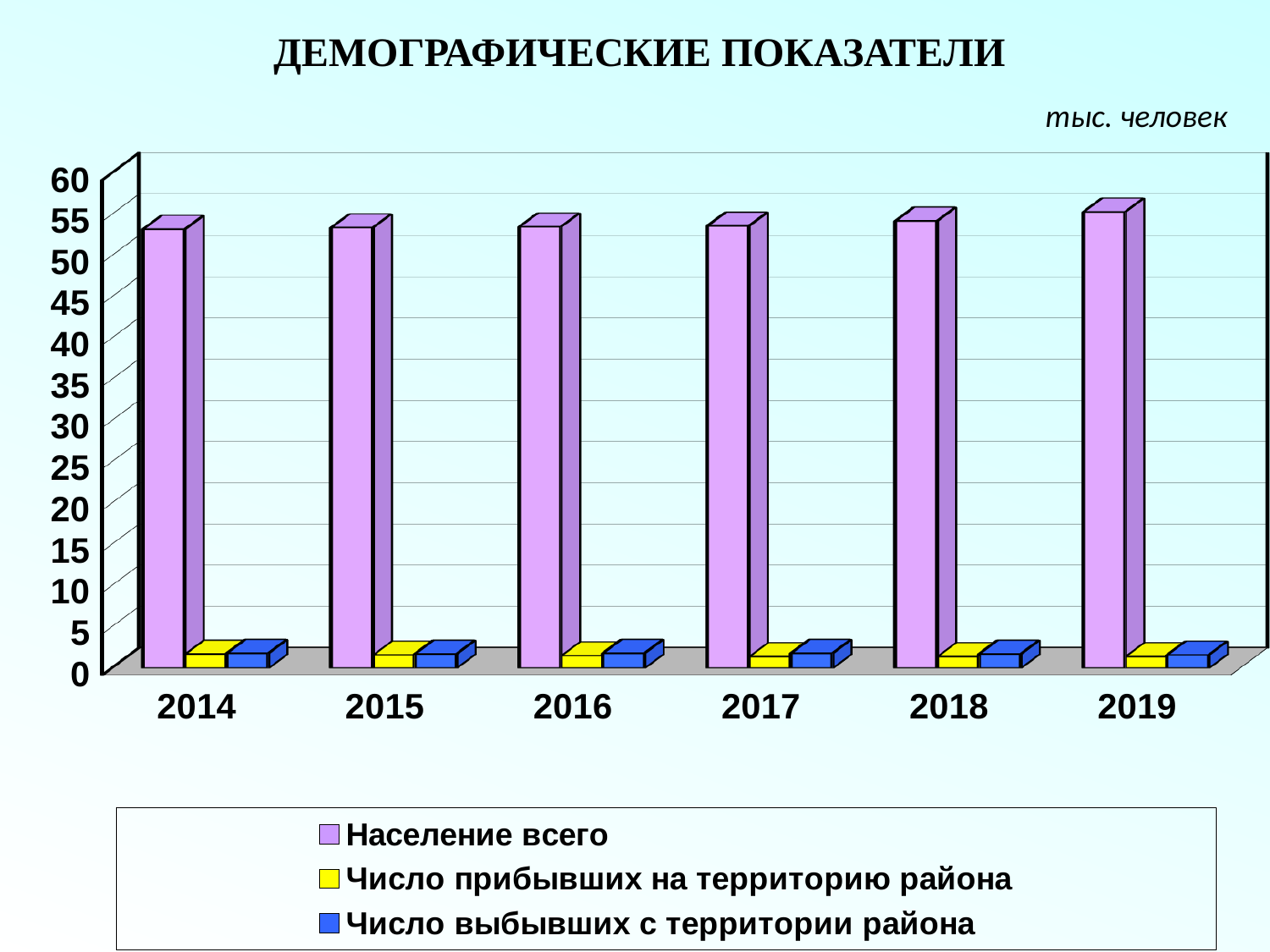
Is the value for Число прибывших на территорию района in 2016 greater or less than 5? less How many series does the legend list? 3 How many years are shown on the x axis of the chart? 6 Which series has the highest values in every year shown? Население всего What kind of chart is shown on the slide? bar chart Is the value for Население всего in 2019 greater or less than 60? less Is the value for Число выбывших с территории района in 2018 greater or less than 10? less What is the title of the chart? ДЕМОГРАФИЧЕСКИЕ ПОКАЗАТЕЛИ What unit is indicated for the values in the chart? тыс. человек In 2017, which is larger: Население всего or Число прибывших на территорию района? Население всего